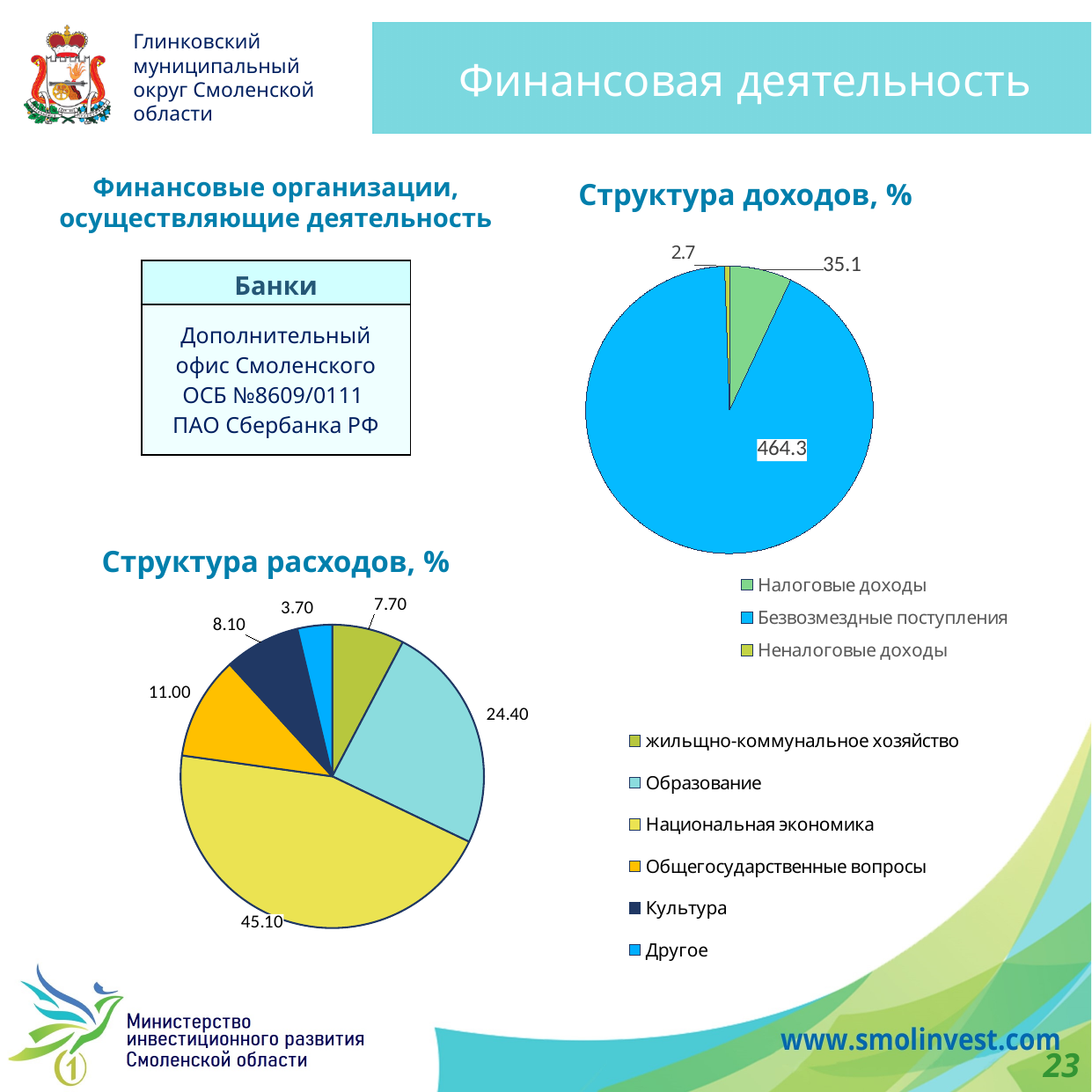
In the chart titled "Структура доходов, %", how many categories does the legend list? 3 In the chart titled "Структура доходов, %", what is the value for Налоговые доходы? 35.1 In the chart titled "Структура расходов, %", what is the value for Образование? 24.40 In the chart titled "Структура расходов, %", which category has the largest value? Национальная экономика In the chart titled "Структура доходов, %", which category has the smallest value? Неналоговые доходы In the chart titled "Структура расходов, %", what is the value for Культура? 8.10 In the chart titled "Структура доходов, %", what is the difference between the values for Налоговые доходы and Неналоговые доходы? 32.4 In the chart titled "Структура доходов, %", what is the value for Безвозмездные поступления? 464.3 In the chart titled "Структура расходов, %", which is larger: Общегосударственные вопросы or жильщно-коммунальное хозяйство? Общегосударственные вопросы In the chart titled "Структура расходов, %", which category has the smallest value? Другое In the chart titled "Структура расходов, %", what is the difference between the values for Национальная экономика and Образование? 20.70 What type of chart is used for "Структура расходов, %"? Pie chart